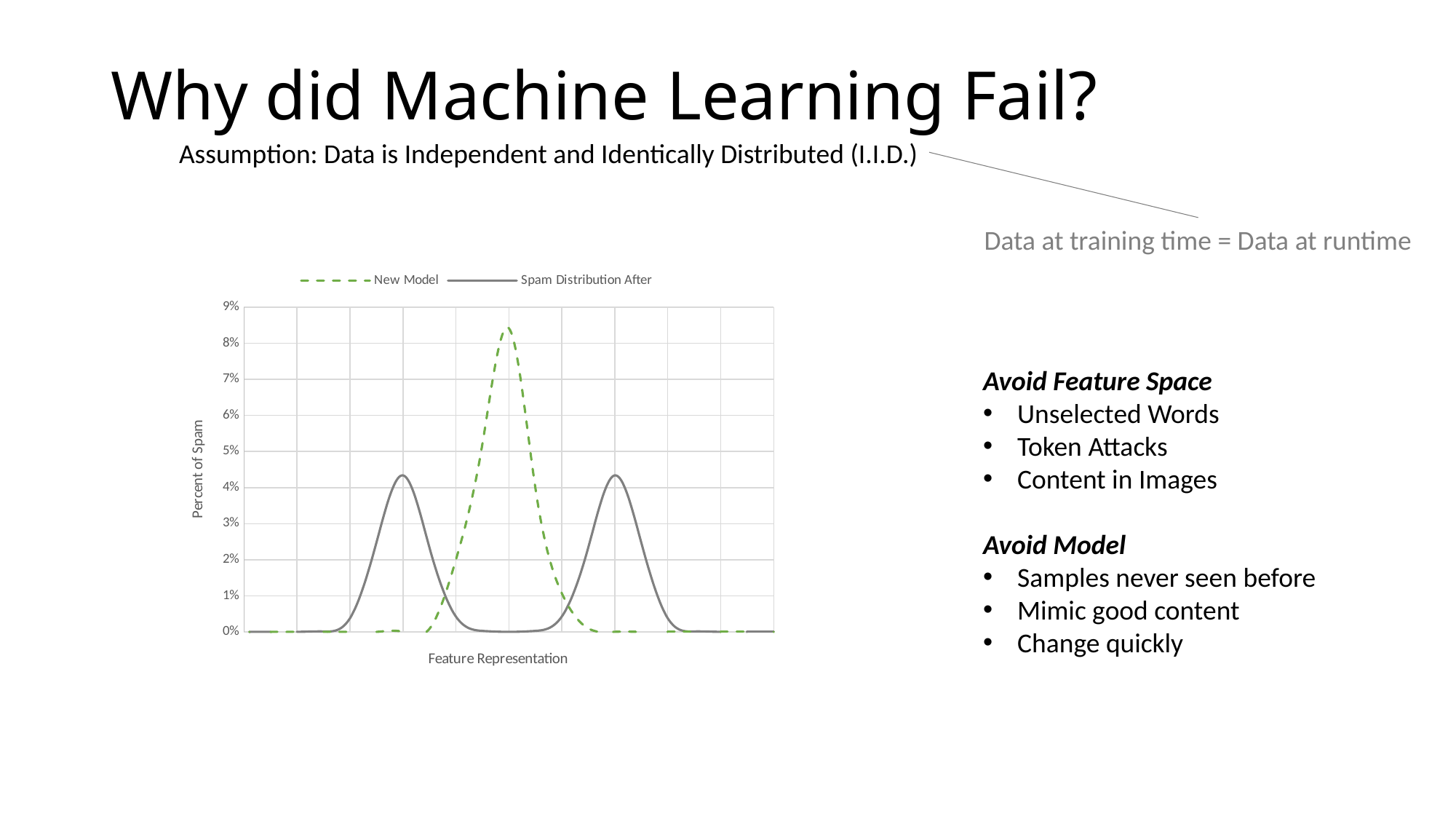
Is the peak value of the Spam Distribution After line greater or less than 4%? greater How many series does the chart's legend list? 2 Is the peak value of the New Model line greater or less than 8%? greater What is the highest value labelled on the chart's vertical axis? 9% How many peaks does the New Model line have? 1 Is the peak value of the Spam Distribution After line greater or less than 5%? less What are the two series named in the chart's legend? New Model and Spam Distribution After How many peaks does the Spam Distribution After line have? 2 What kind of chart is shown on the slide? line chart Which series reaches a higher peak, New Model or Spam Distribution After? New Model What is the title of the chart's vertical axis? Percent of Spam